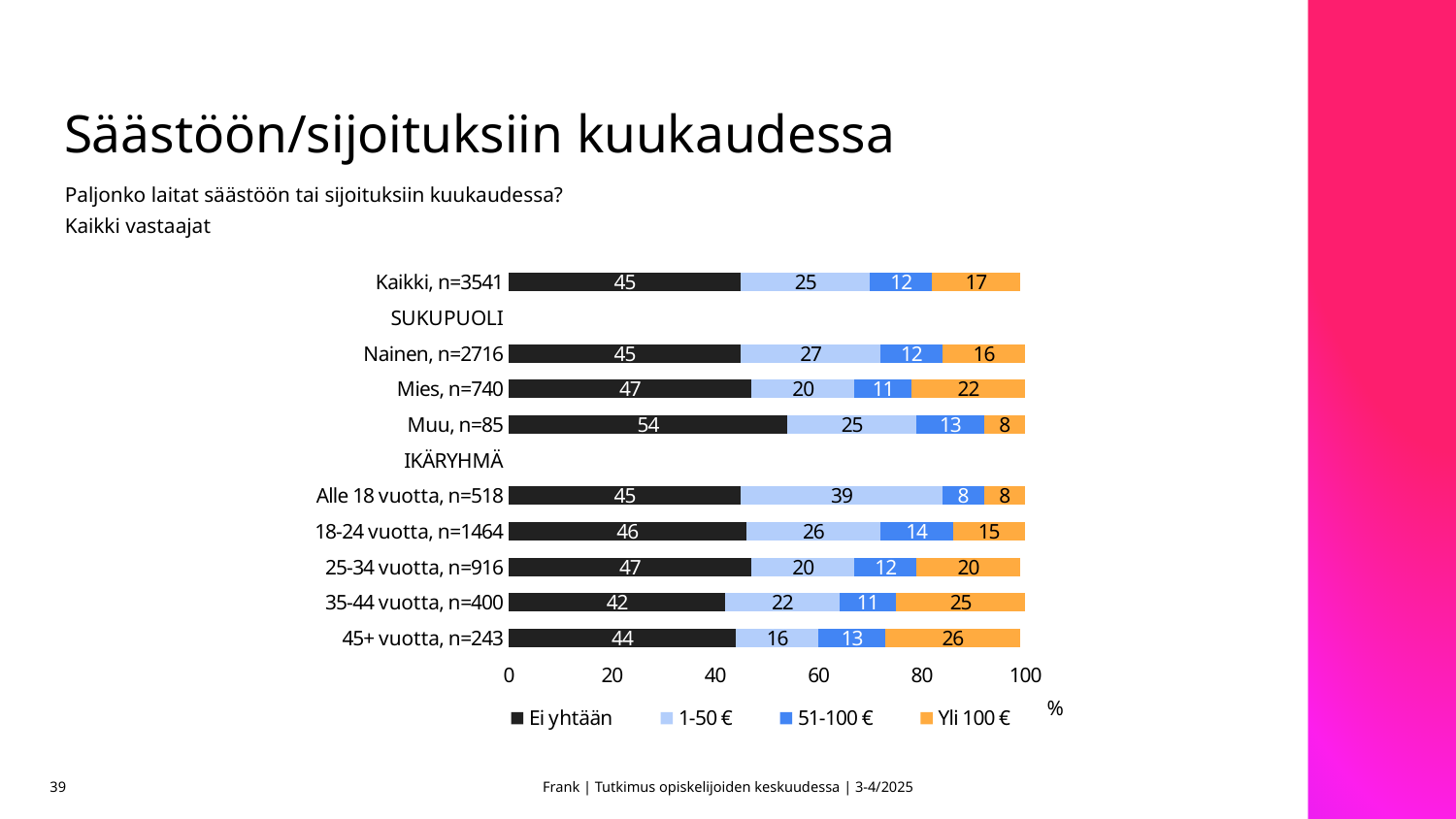
What is the difference between the 'Yli 100 €' values for Mies, n=740 and Nainen, n=2716? 6 Which group has the lowest 'Yli 100 €' value? Muu, n=85 and Alle 18 vuotta, n=518 (both 8) Which group has the highest 'Ei yhtään' value? Muu, n=85 What is the total of the stacked bar for Kaikki, n=3541? 99 What is the value of 'Yli 100 €' for 45+ vuotta, n=243? 26 What type of chart is shown on the slide? Stacked bar chart What is the value of 'Ei yhtään' for Muu, n=85? 54 Which is larger: the '1-50 €' value for Nainen, n=2716 or for Mies, n=740? Nainen, n=2716 How many series does the legend list? 4 How many groups have bars plotted in the chart? 9 What is the value of '51-100 €' for 18-24 vuotta, n=1464? 14 What is the value of '1-50 €' for Alle 18 vuotta, n=518? 39